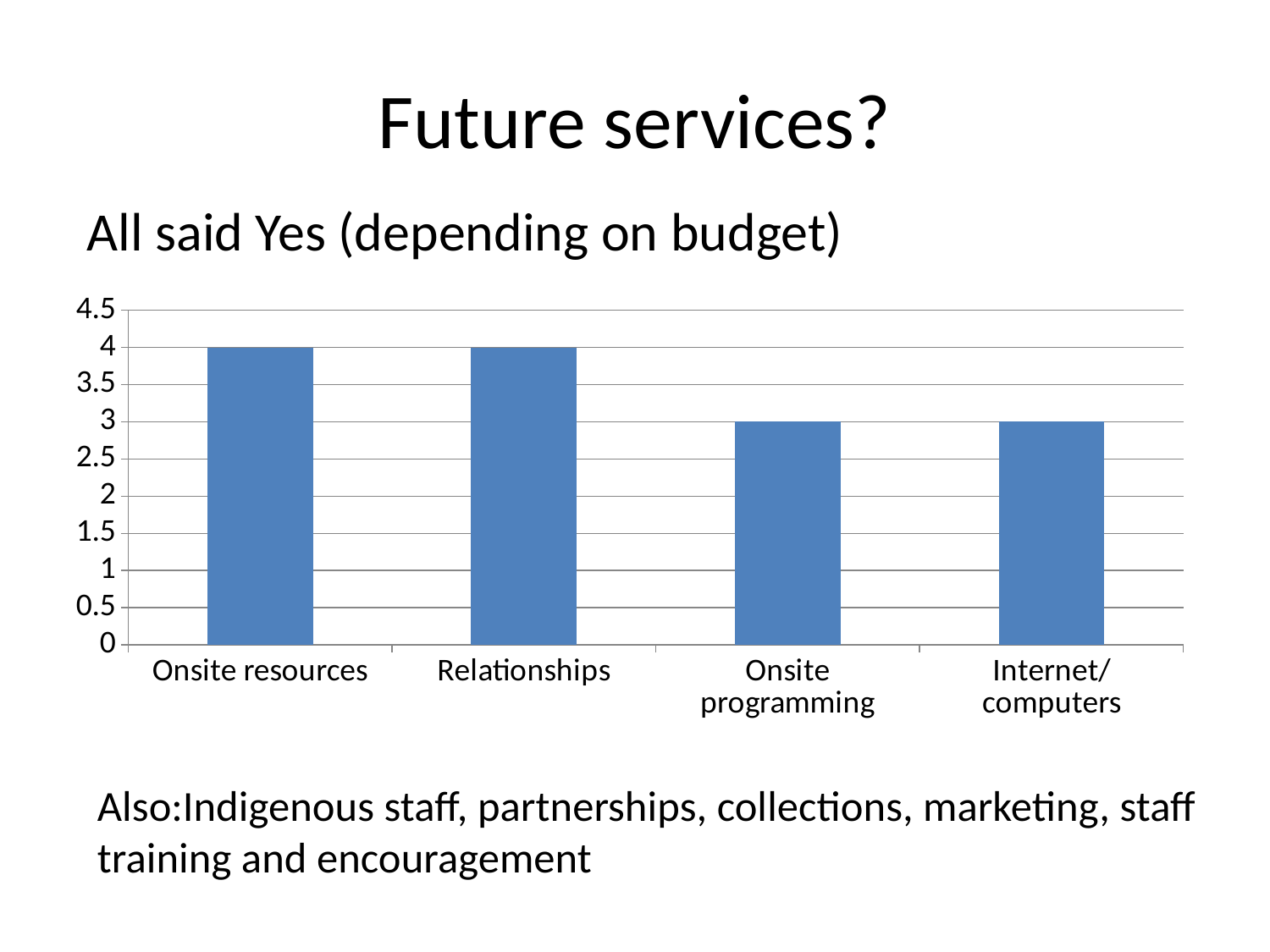
What is the highest value shown on the vertical axis of the chart? 4.5 How many categories are shown on the x axis of the chart? 4 Is the value for Onsite programming greater or less than 3.5? less Which is larger, the value for Onsite resources or the value for Onsite programming? Onsite resources What is the value for Relationships? 4 What is the difference between the value for Relationships and the value for Internet/computers? 1 What kind of chart is shown on the slide? bar chart What is the value for Onsite programming? 3 What is the value for Onsite resources? 4 What is the value for Internet/computers? 3 Is the value for Relationships greater or less than 3.5? greater Which is larger, the value for Internet/computers or the value for Relationships? Relationships